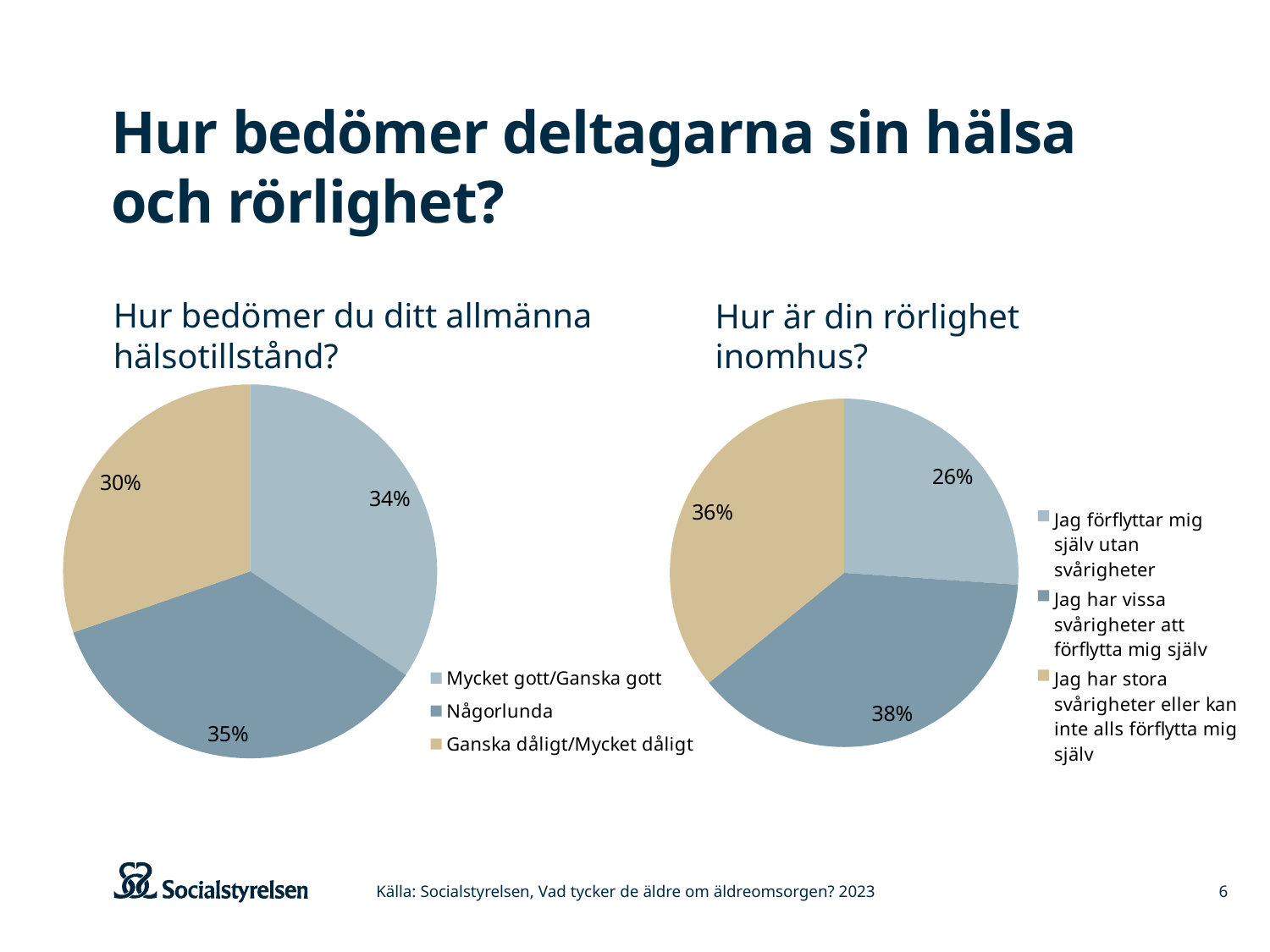
How many slices does the chart 'Hur är din rörlighet inomhus?' have? 3 What kind of chart is used for 'Hur bedömer du ditt allmänna hälsotillstånd?'? Pie chart In the chart 'Hur är din rörlighet inomhus?', what is the difference in percentage points between the largest and smallest slices? 12 percentage points In the chart 'Hur är din rörlighet inomhus?', what share answered 'Jag har vissa svårigheter att förflytta mig själv'? 38% In the chart 'Hur är din rörlighet inomhus?', which answer has the smallest share? Jag förflyttar mig själv utan svårigheter In the chart 'Hur bedömer du ditt allmänna hälsotillstånd?', what share answered Ganska dåligt/Mycket dåligt? 30% In the chart 'Hur bedömer du ditt allmänna hälsotillstånd?', what share answered Någorlunda? 35% In the chart 'Hur bedömer du ditt allmänna hälsotillstånd?', what share answered Mycket gott/Ganska gott? 34% In the chart 'Hur bedömer du ditt allmänna hälsotillstånd?', which answer has the smallest share? Ganska dåligt/Mycket dåligt In the chart 'Hur är din rörlighet inomhus?', what share answered 'Jag förflyttar mig själv utan svårigheter'? 26% In the chart 'Hur är din rörlighet inomhus?', which answer has the largest share? Jag har vissa svårigheter att förflytta mig själv In the chart 'Hur är din rörlighet inomhus?', what share answered 'Jag har stora svårigheter eller kan inte alls förflytta mig själv'? 36%